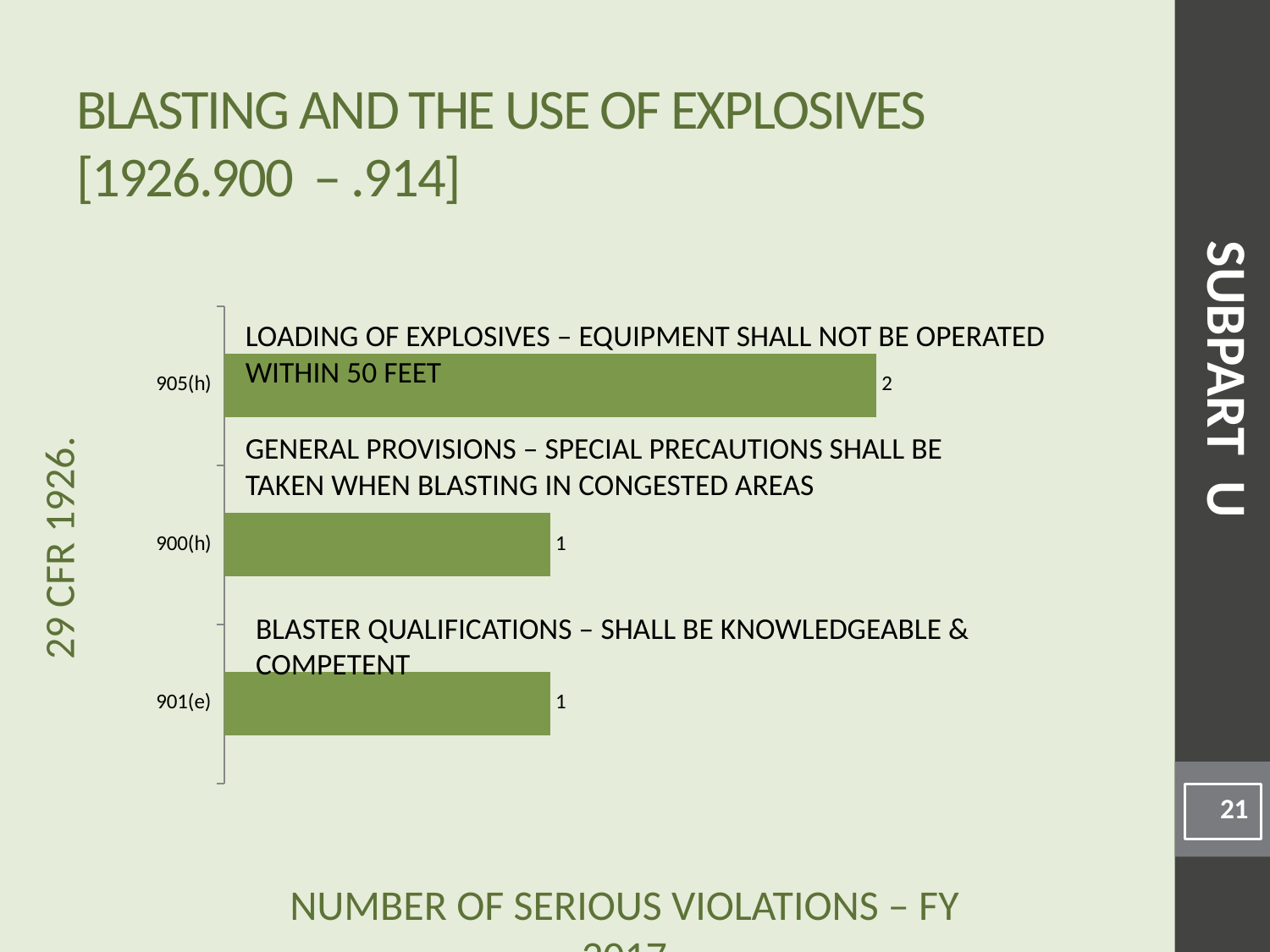
What is the number of serious violations for 900(h)? 1 What is the y-axis label of the chart? 29 CFR 1926. What kind of chart is shown on the slide? Bar chart What is the number of serious violations for 901(e)? 1 What is the difference between the values for 905(h) and 900(h)? 1 Which category is labeled 'BLASTER QUALIFICATIONS – SHALL BE KNOWLEDGEABLE & COMPETENT'? 901(e) How many categories are shown in the chart? 3 Which has a larger value, 905(h) or 901(e)? 905(h) What is the number of serious violations for 905(h)? 2 Which category has the highest number of serious violations? 905(h) What is the total number of serious violations across all three categories? 4